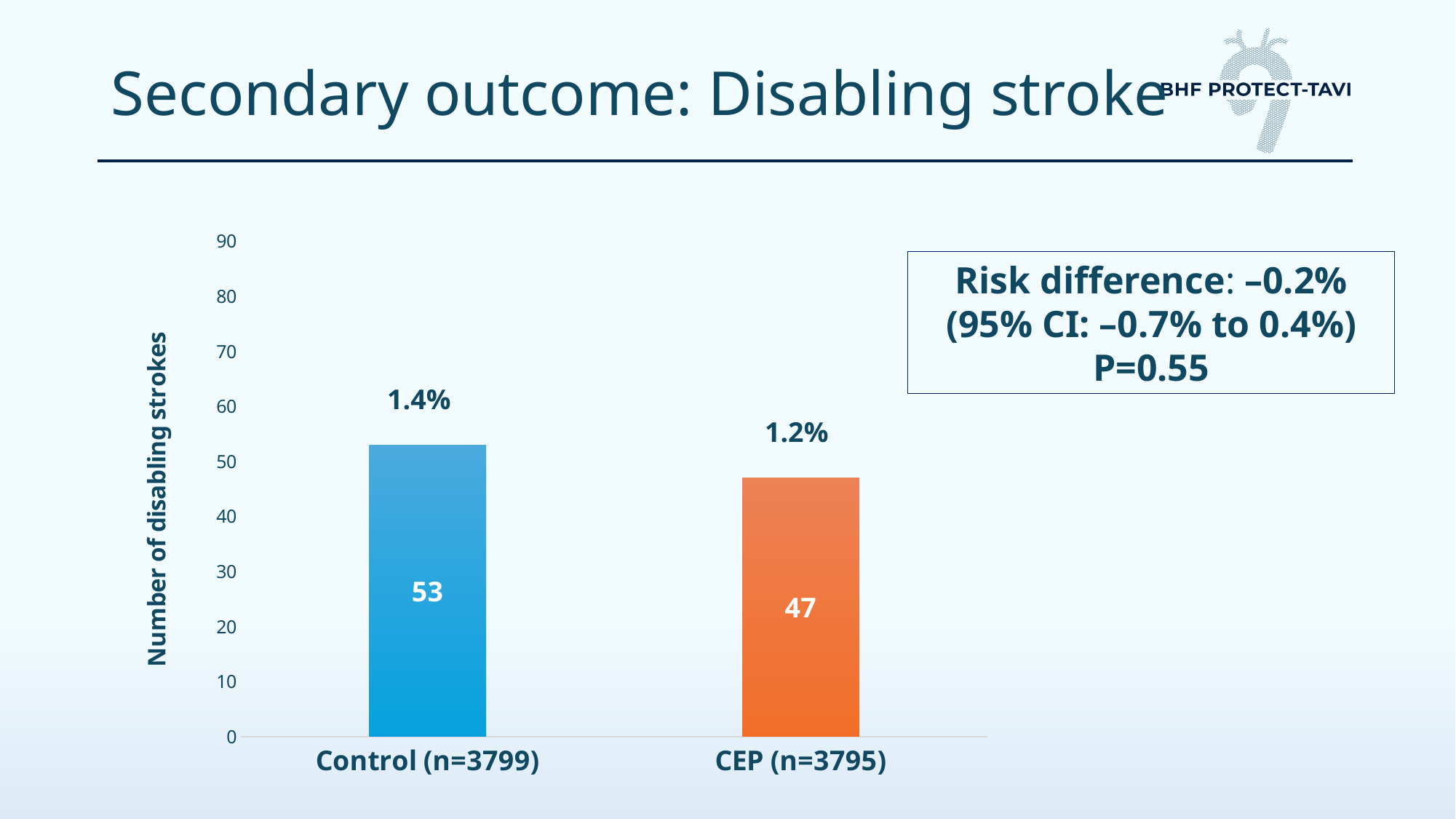
Which group has the lower number of disabling strokes? CEP (n=3795) What is the number of disabling strokes in the Control (n=3799) group? 53 Is the number of disabling strokes in the CEP group greater or less than 50? less What percentage is shown above the CEP (n=3795) bar? 1.2% Which group has the higher number of disabling strokes? Control (n=3799) How many groups are plotted on the chart? 2 What is the label of the y axis? Number of disabling strokes What is the difference in the number of disabling strokes between the Control and CEP groups? 6 What is the number of disabling strokes in the CEP (n=3795) group? 47 What kind of chart is shown on the slide? Bar chart What percentage is shown above the Control (n=3799) bar? 1.4% Is the number of disabling strokes in the Control group greater or less than 50? greater